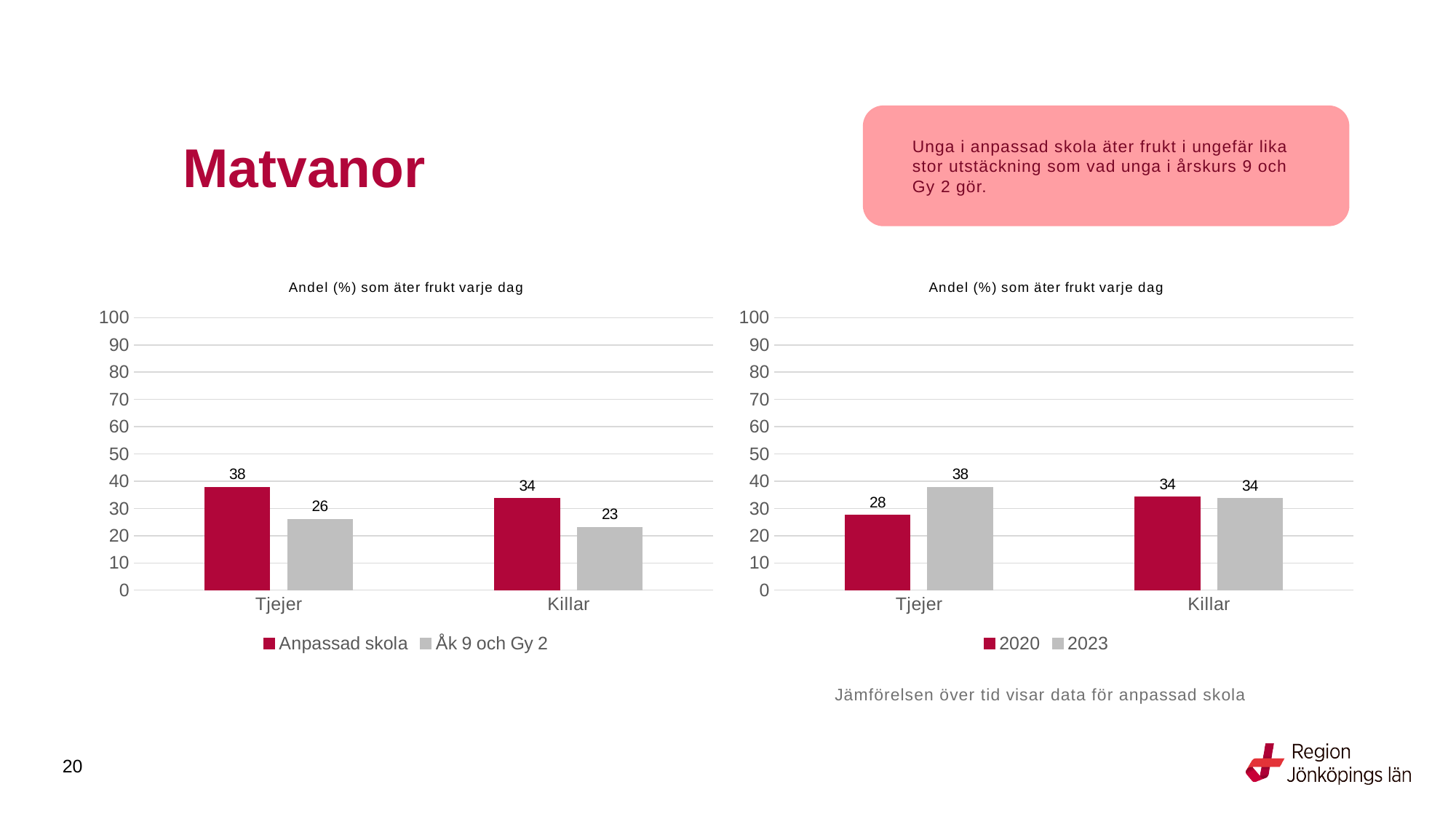
In the left chart, what is the value for Anpassad skola for Tjejer? 38 In the right chart, what is the value for 2023 for Tjejer? 38 What kind of chart is the left chart? Bar chart In the right chart, what is the difference between 2023 and 2020 for Tjejer? 10 In the left chart, what is the value for Åk 9 och Gy 2 for Killar? 23 In the right chart, how many categories are shown on the x axis? 2 In the right chart, what is the value for 2020 for Tjejer? 28 In the right chart, is the value for 2020 for Killar greater or less than 50? less In the left chart, which series has the higher value for Killar, Anpassad skola or Åk 9 och Gy 2? Anpassad skola In the left chart, what is the difference between Anpassad skola and Åk 9 och Gy 2 for Tjejer? 12 What is the title of the right chart? Andel (%) som äter frukt varje dag In the left chart, how many series does the legend list? 2